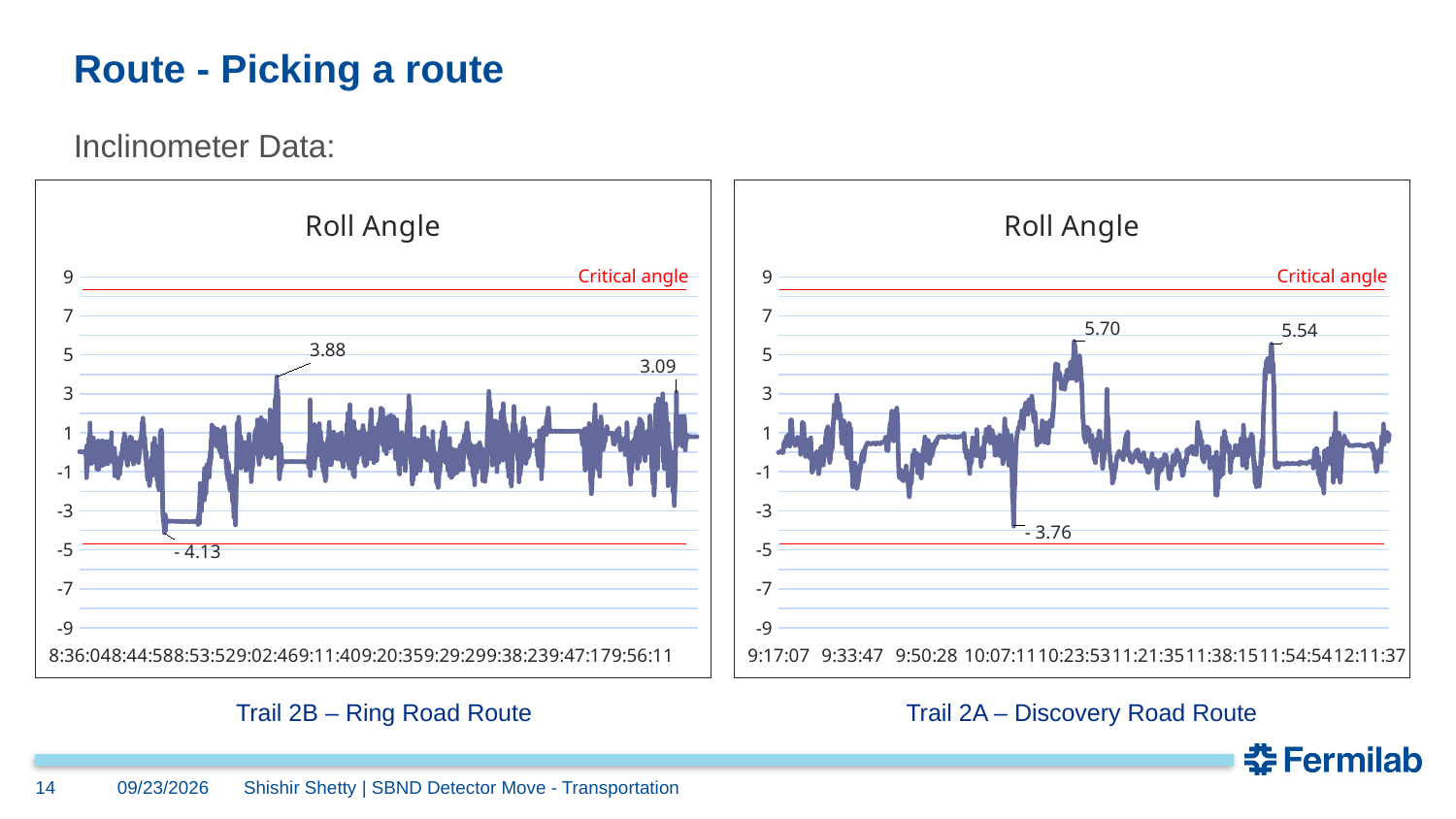
Which chart has the larger labelled maximum roll angle, the left (Trail 2B – Ring Road Route) or the right (Trail 2A – Discovery Road Route)? the right (Trail 2A – Discovery Road Route) On the right chart (Trail 2A – Discovery Road Route), what is the lowest labelled roll angle value? -3.76 On the left chart (Trail 2B – Ring Road Route), what is the difference between the labelled peaks 3.88 and 3.09? 0.79 On the right chart (Trail 2A – Discovery Road Route), what is the difference between the two labelled peaks 5.70 and 5.54? 0.16 On the left chart (Trail 2B – Ring Road Route), what is the lowest labelled roll angle value? -4.13 On the right chart (Trail 2A – Discovery Road Route), what is the highest labelled roll angle value? 5.70 What label is written next to the red horizontal line near the top of each chart? Critical angle On the right chart (Trail 2A – Discovery Road Route), what is the second labelled peak value, to the right of 5.70? 5.54 What is the title of the right chart (Trail 2A – Discovery Road Route)? Roll Angle On the left chart (Trail 2B – Ring Road Route), what is the labelled peak value near the right end of the series? 3.09 On the left chart (Trail 2B – Ring Road Route), what is the highest labelled roll angle value? 3.88 What kind of chart is the left chart (Trail 2B – Ring Road Route)? line chart